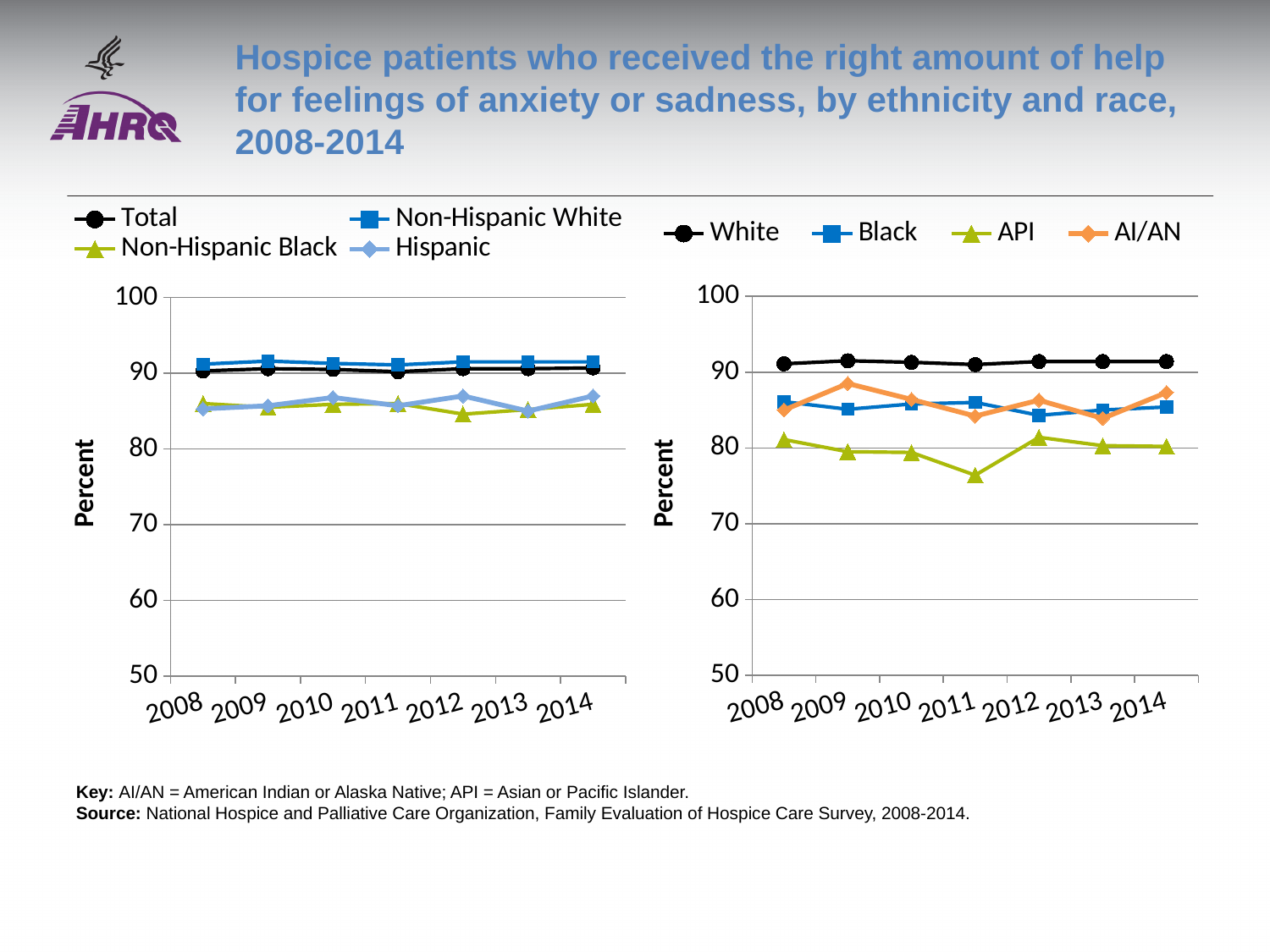
How many years are plotted on the x axis of the left chart? 7 What is the y-axis label of the left chart? Percent What kind of chart is the left chart (Total, Non-Hispanic White, Non-Hispanic Black, Hispanic)? Line chart How many series does the legend of the right chart (White, Black, API, AI/AN) list? 4 In the right chart, is the value for White in 2014 greater or less than 90? greater In the right chart, which series has the highest values across all years? White In the right chart, which is larger in 2011: White or API? White In the right chart, which series has the lowest values across all years? API In the left chart, is the value for Non-Hispanic Black in 2012 greater or less than 90? less In the right chart, is the value for API in 2011 greater or less than 80? less In the right chart, does the API line rise or fall from 2011 to 2012? Rise